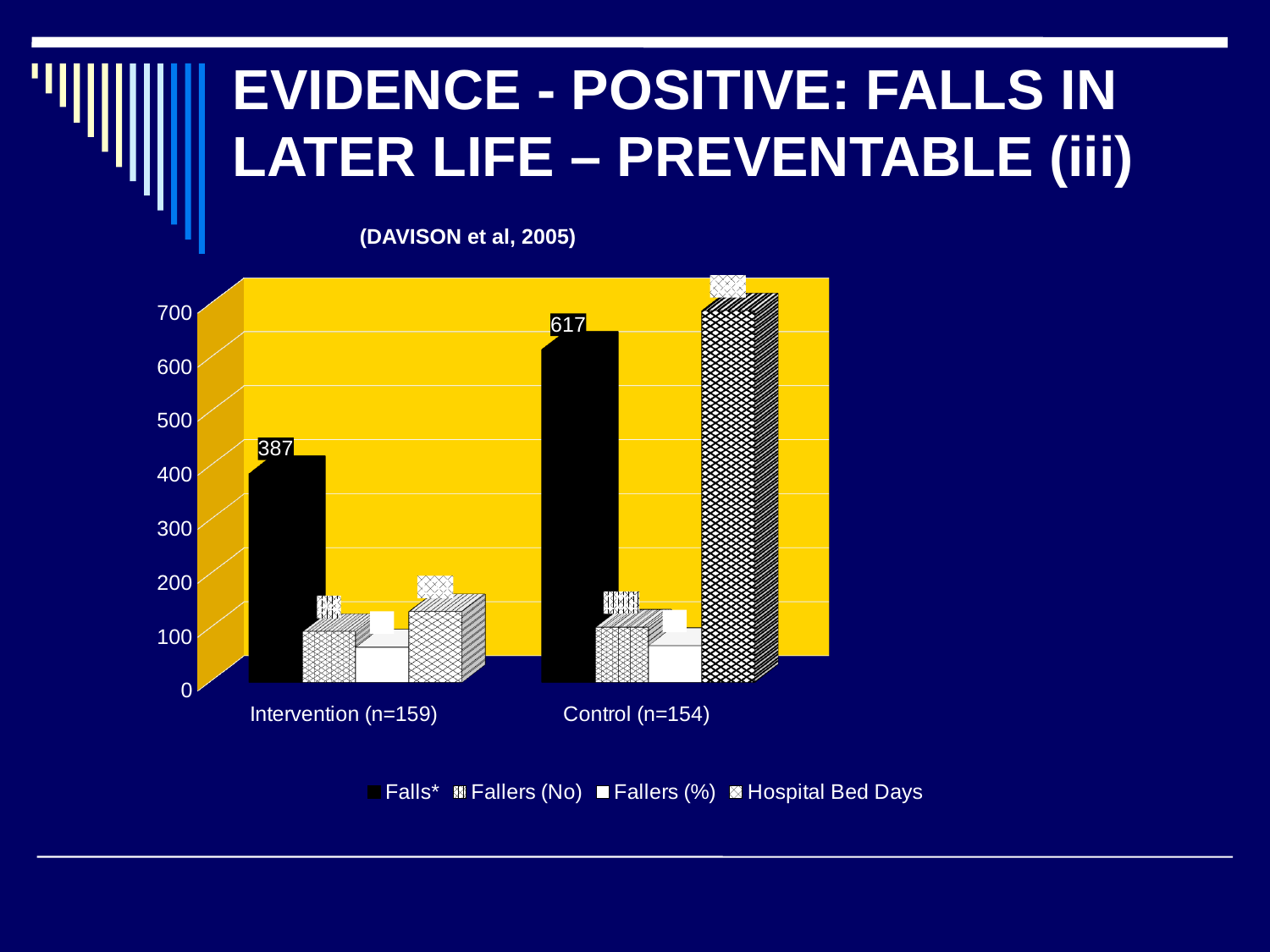
Which group has the higher Falls* value, Intervention (n=159) or Control (n=154)? Control (n=154) What is the difference between the Falls* values for Control (n=154) and Intervention (n=159)? 230 What kind of chart is shown on the slide? bar chart What is the value of Falls* for Intervention (n=159)? 387 How many series does the legend list? 4 Which series has the lowest value in the Intervention (n=159) group? Fallers (%) How many groups are shown on the x axis of the chart? 2 Is the Hospital Bed Days value for Intervention (n=159) greater or less than 300? less What is the value of Falls* for Control (n=154)? 617 Is the Hospital Bed Days value for Control (n=154) greater or less than 600? greater Which series has the highest value in the Control (n=154) group? Hospital Bed Days